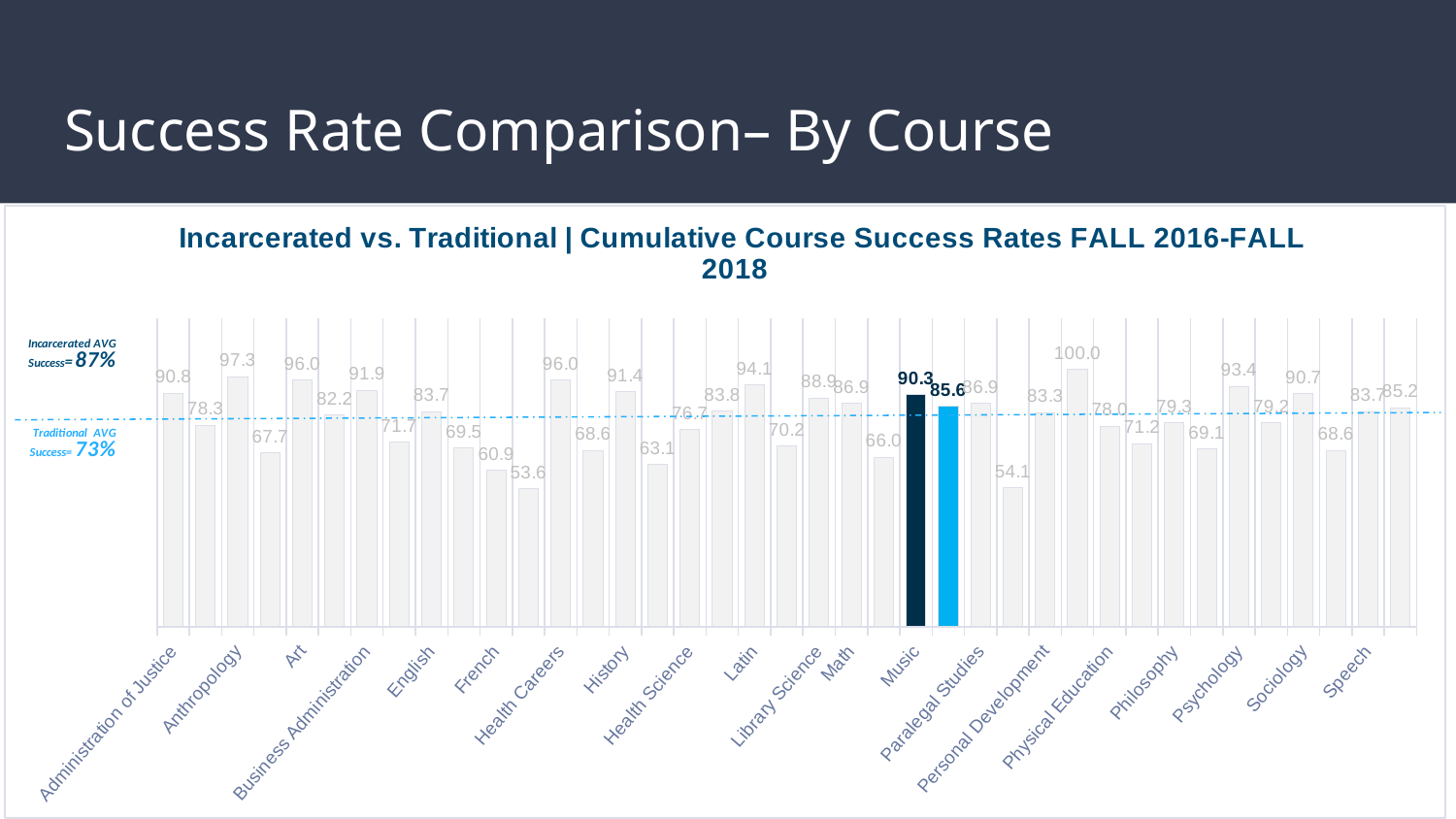
What is the value of the left (first) bar for Anthropology? 97.3 What is the value of the dark navy highlighted bar for Music? 90.3 Which is larger: the left bar for Anthropology or the left bar for Art? Anthropology What type of chart is shown on the slide? Bar chart What Incarcerated AVG Success rate is noted on the left of the chart? 87% What is the value of the light blue highlighted bar for Music? 85.6 What Traditional AVG Success rate is noted on the left of the chart? 73% What is the highest value labeled on the chart? 100.0 What is the lowest value labeled on the chart? 53.6 What is the difference between the two bars for Anthropology (97.3 and 67.7)? 29.6 What is the difference between the two highlighted Music bars (90.3 and 85.6)? 4.7 How many courses are listed along the x axis? 20